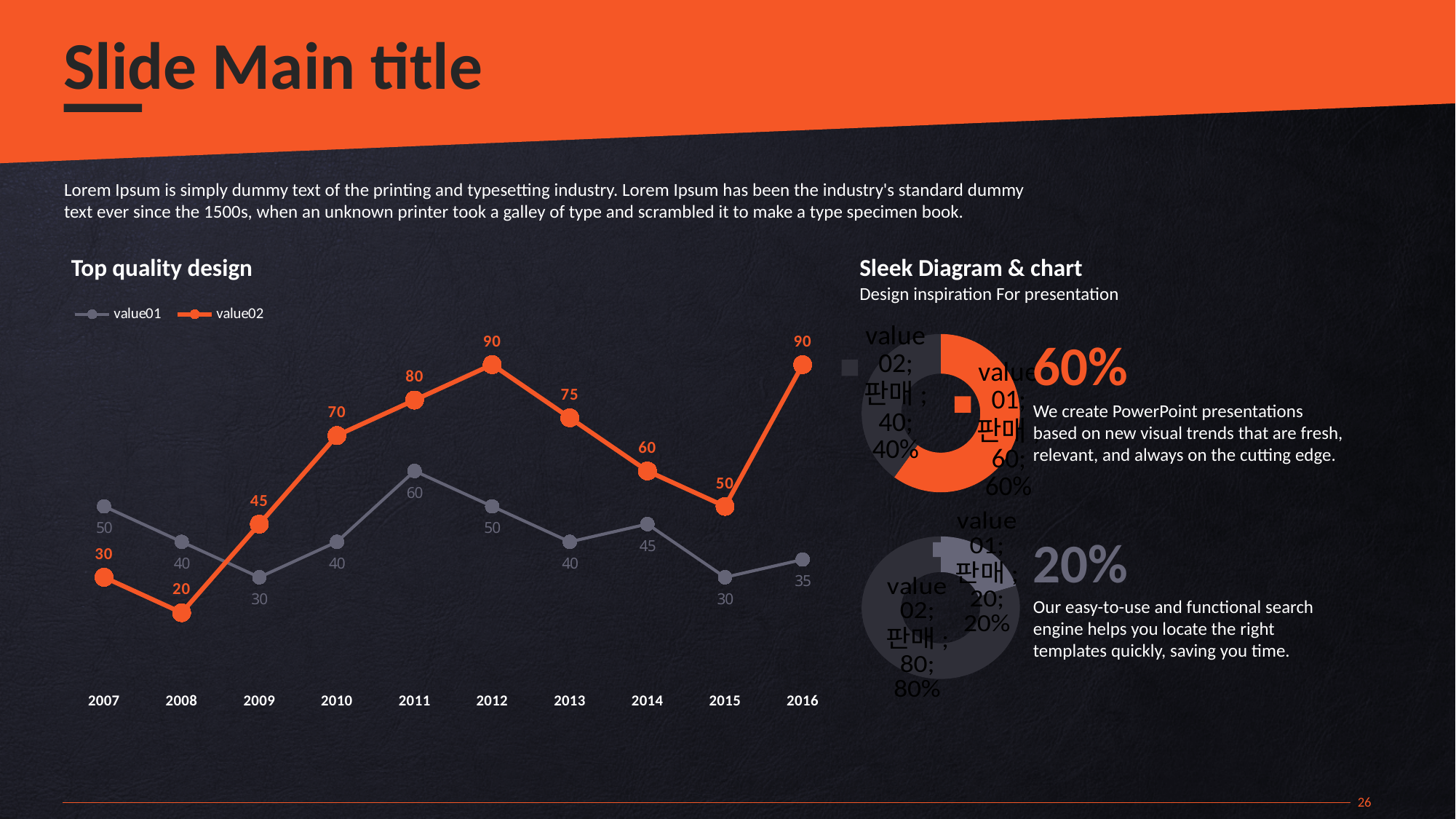
On the line chart, what is the value of value02 in 2008? 20 How many years are shown on the x axis of the line chart? 10 On the line chart, does value02 rise or fall from 2008 to 2012? rise On the line chart, what is the difference between value02 and value01 in 2012? 40 What type of chart is the chart under the heading 'Top quality design'? line chart On the line chart, in which year does value01 reach its highest value? 2011 In the upper donut chart next to '60%', what share does value02 have? 40% On the line chart, in which year does value02 reach its lowest value? 2008 On the line chart, what is the value of value02 in 2012? 90 On the line chart, which series has the larger value in 2007, value01 or value02? value01 How many series does the legend of the line chart list? 2 On the line chart, what is the value of value01 in 2011? 60